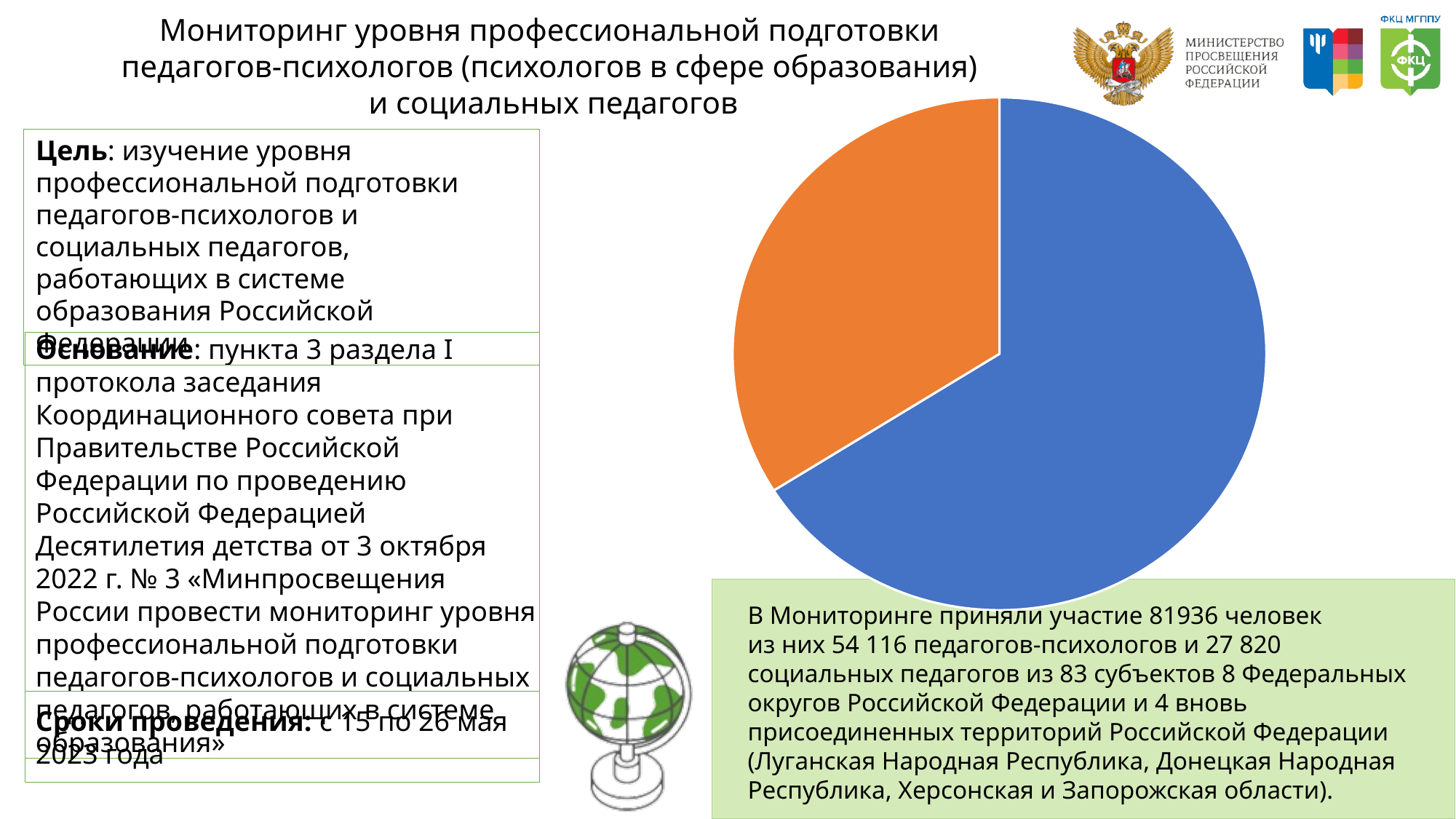
Which slice of the pie chart is the largest, the blue one or the orange one? blue Does the pie chart display a legend? No Does the blue slice cover more or less than half of the pie chart? more Does the orange slice cover more or less than half of the pie chart? less What two colours are used for the slices of the pie chart? blue and orange How many slices does the pie chart have? 2 Which slice of the pie chart is the smallest, the blue one or the orange one? orange Is the blue slice of the pie chart larger or smaller than the orange slice? larger What kind of chart is shown on the slide? pie chart